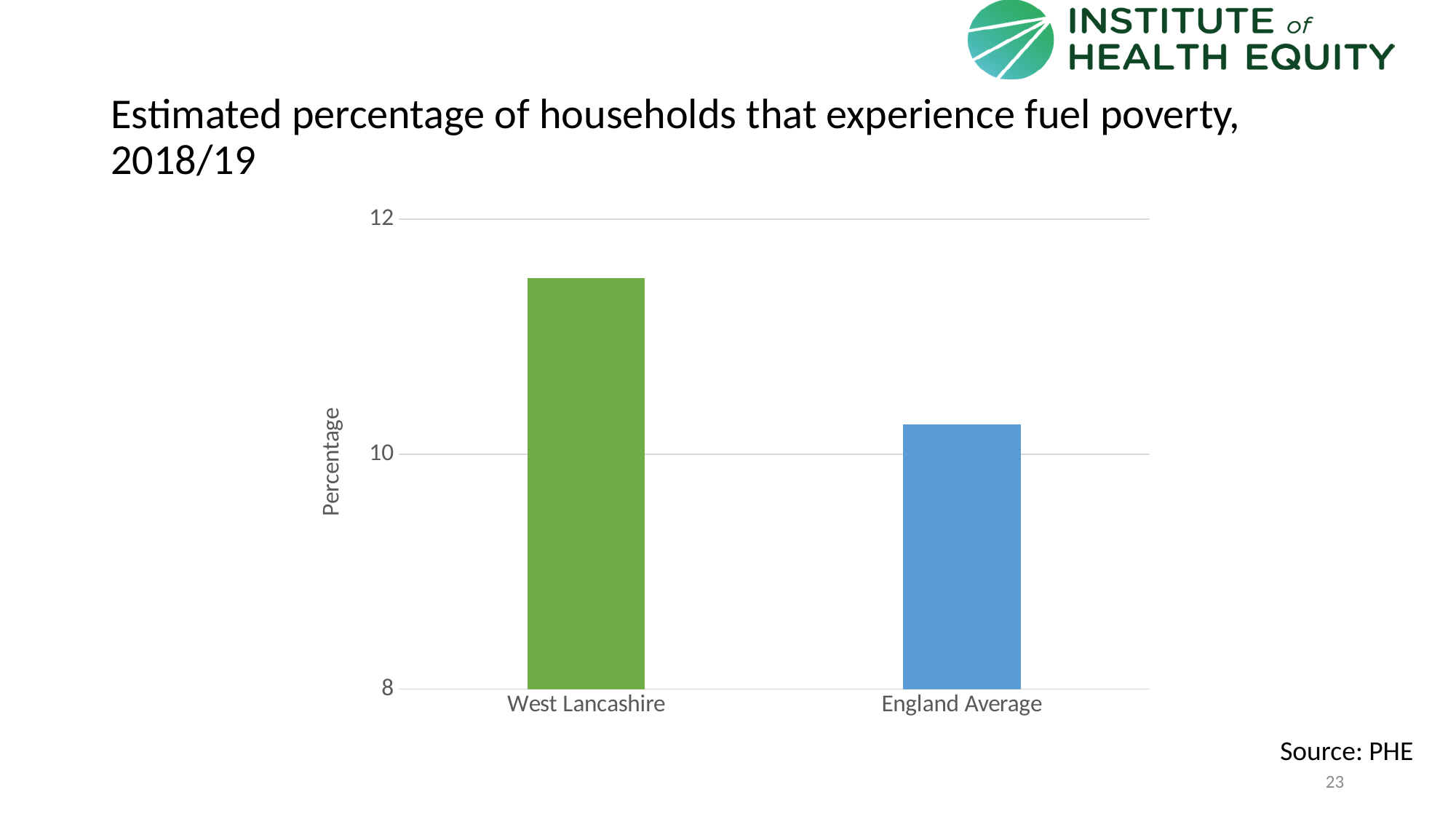
Which category has the lowest estimated percentage of households experiencing fuel poverty? England Average What is the source cited for the chart? PHE How many categories are shown on the chart? 2 What colour is the bar for West Lancashire? Green What is the label on the vertical axis of the chart? Percentage Is the value for England Average greater or less than 12? less Is the value for West Lancashire greater or less than 12? less Is the value for England Average greater or less than 10? greater Which is larger, the value for West Lancashire or the value for England Average? West Lancashire What kind of chart is shown on the slide? Bar chart Which category has the highest estimated percentage of households experiencing fuel poverty? West Lancashire